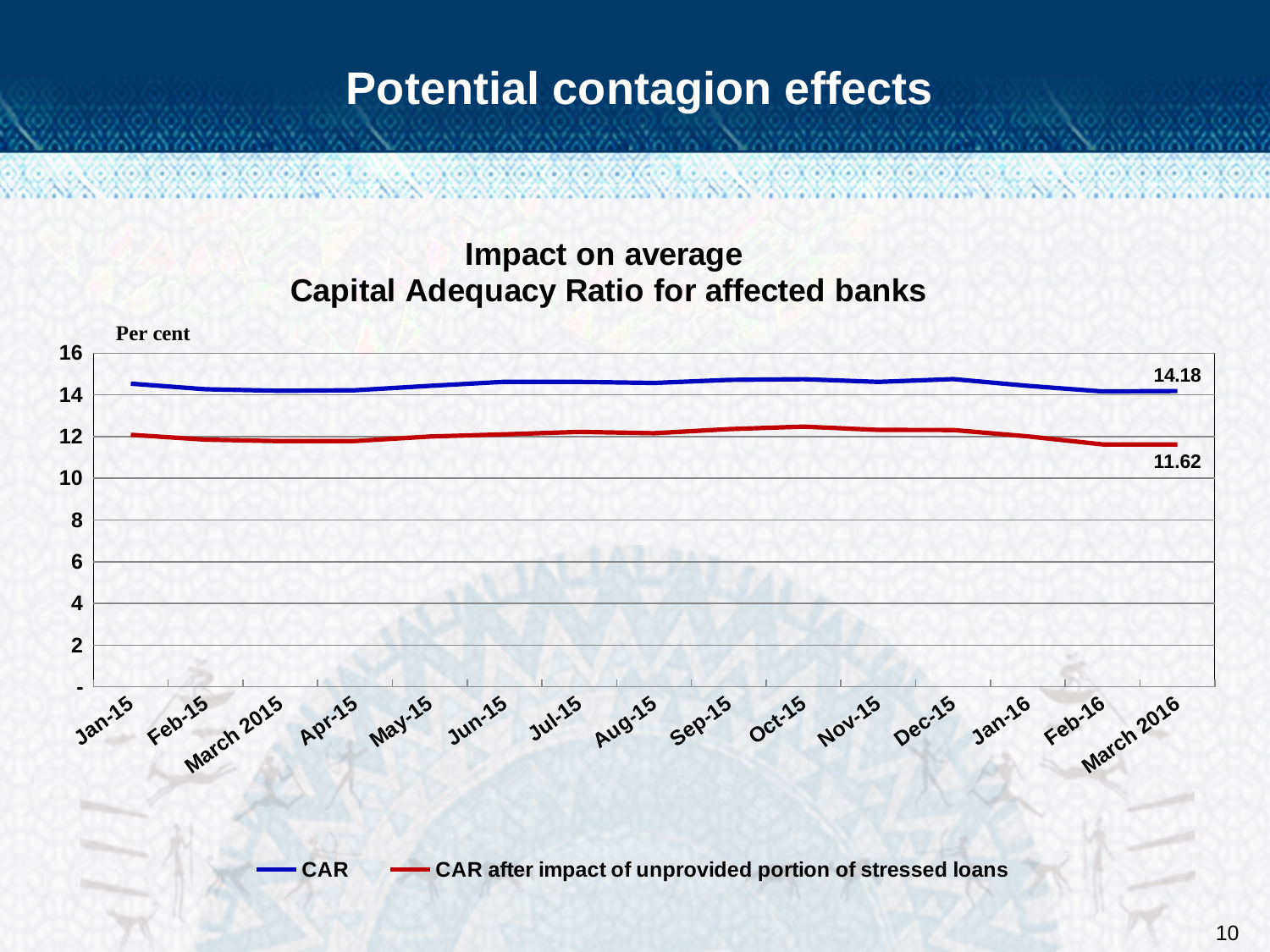
Between Dec-15 and March 2016, does the CAR line rise or fall? fall What is the value of CAR in March 2016? 14.18 What is the value of CAR after impact of unprovided portion of stressed loans in March 2016? 11.62 Is the value for CAR after impact of unprovided portion of stressed loans in Feb-16 greater or less than 12? less What kind of chart is shown on the slide? line chart In March 2016, which is larger: CAR or CAR after impact of unprovided portion of stressed loans? CAR Is the value for CAR in Jan-15 greater or less than 14? greater What unit is shown on the y axis of the chart? Per cent Is the value for CAR after impact of unprovided portion of stressed loans in Oct-15 greater or less than 12? greater How many time points are shown on the x axis? 15 How many series does the legend list? 2 What is the difference between CAR and CAR after impact of unprovided portion of stressed loans in March 2016? 2.56